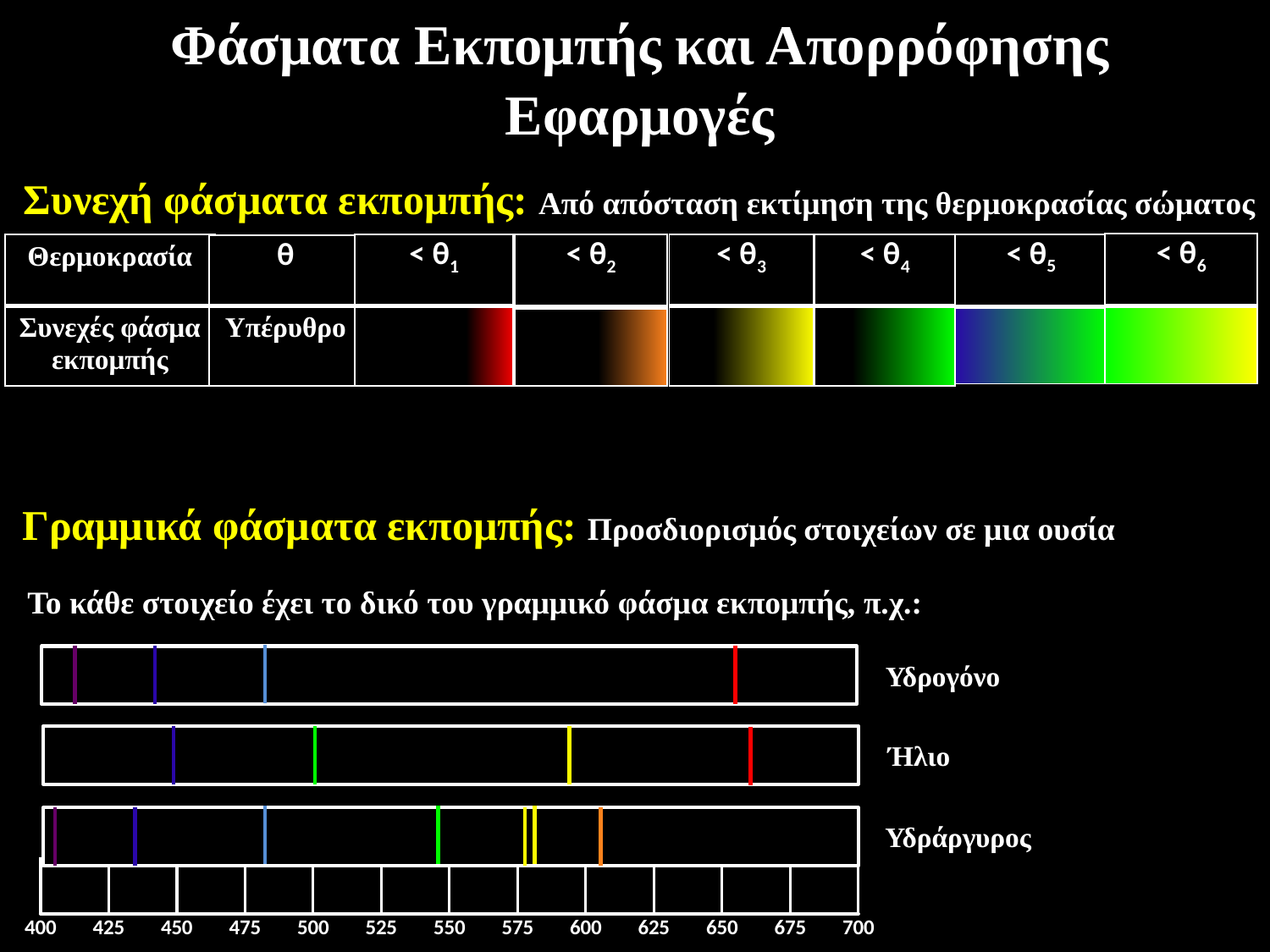
Is the wavelength of the red line in the helium spectrum greater or less than 650? greater Is the wavelength of the red line in the hydrogen spectrum greater or less than 625? greater Is the wavelength of the yellow line in the helium spectrum greater or less than 575? greater How many temperature columns (θ, <θ1, ... <θ6) are shown in the continuous emission spectrum table? 7 How many emission lines are shown in the mercury (Υδράργυρος) line spectrum? 7 How many emission lines are shown in the helium (Ήλιο) line spectrum? 4 What is the range of the wavelength axis below the line spectra? 400 to 700 Which of the three elements shown has the most emission lines in its line spectrum? Υδράργυρος